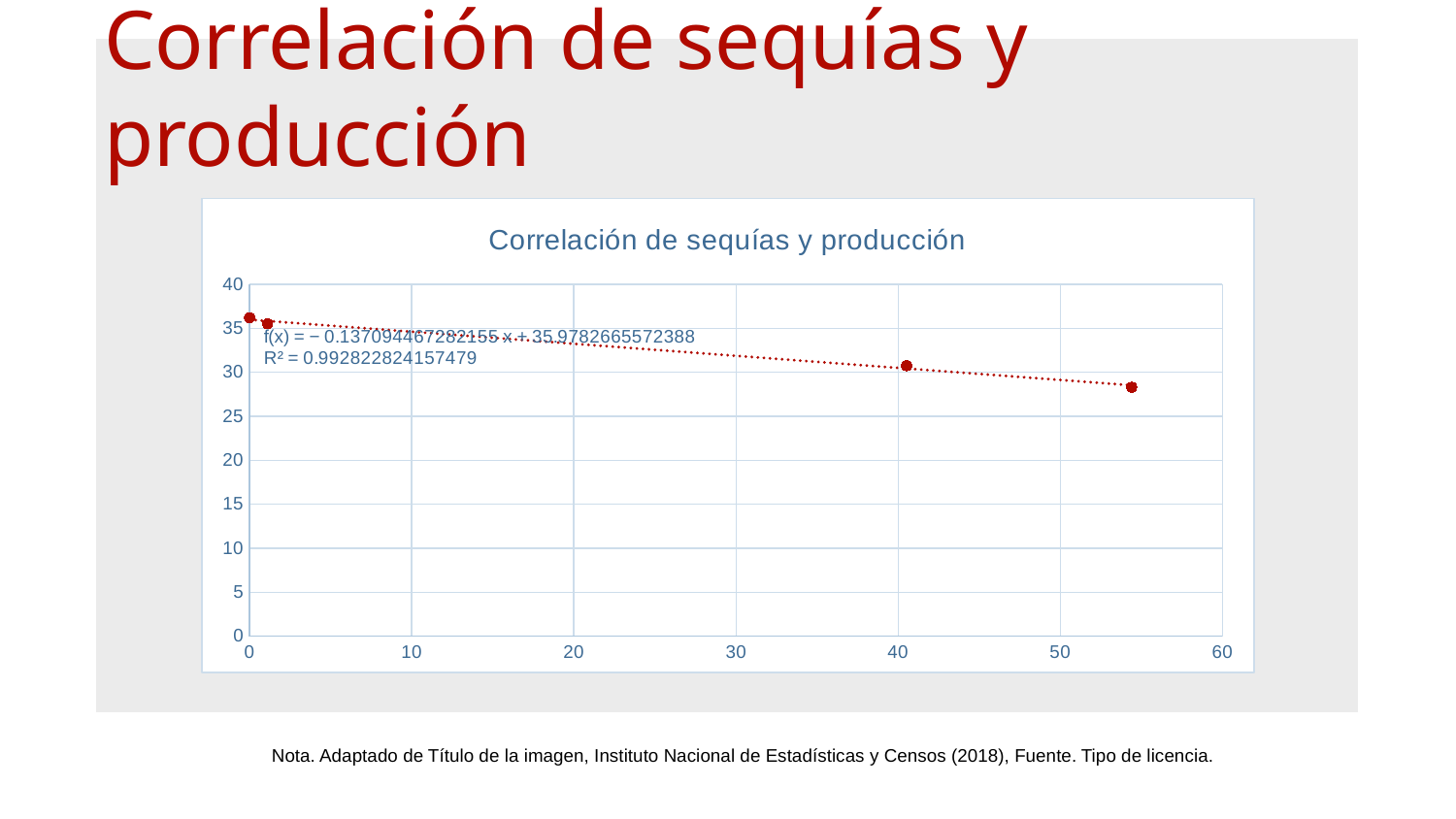
What is the trendline equation printed on the chart? f(x) = − 0.137094467282155 x + 35.9782665572388 What R² value is printed on the chart? 0.992822824157479 What is the title of the chart? Correlación de sequías y producción Is the value of the point at x = 0 greater or less than 35? greater What kind of chart is shown on the slide? scatter chart Is the slope of the trendline positive or negative? negative What is the highest value shown on the y axis? 40 Is the value of the point at about x = 40 greater or less than 30? greater Which point has the higher value: the one at x = 0 or the one at about x = 54? the one at x = 0 Do the plotted values rise or fall as the x value increases? fall Is the value of the point at about x = 54 greater or less than 30? less